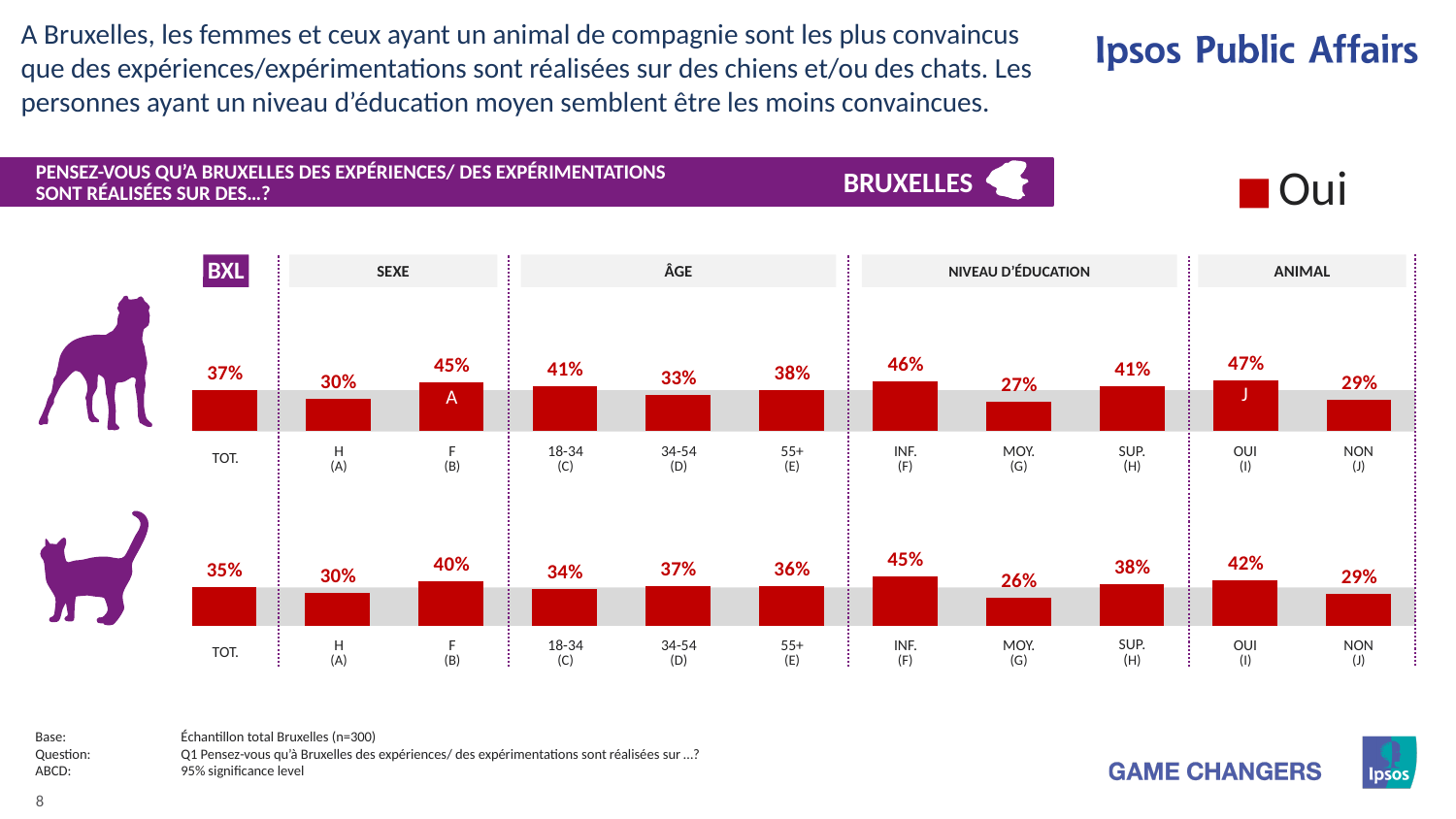
How many categories (bars) are shown in the bottom chart (cat row)? 11 In the bottom chart (cat row), what is the value for 34-54 (D) under ÂGE? 37% In the bottom chart (cat row), what is the difference between the values for INF. (F) and SUP. (H)? 7% In the bottom chart (cat row), which category has the lowest value? MOY. (G) What type of chart is used on this slide? Bar chart In the top chart (dog row), what is the difference between the values for F (B) and H (A)? 15% In the top chart (dog row), which category has the highest value? OUI (I) In the top chart (dog row), what is the value for MOY. (G) under NIVEAU D'ÉDUCATION? 27% In the bottom chart (cat row), what is the value for F (B) under SEXE? 40% In the top chart (dog row), which is larger: the value for 18-34 (C) or the value for 55+ (E)? 18-34 (C) What is the single legend entry shown on the slide? Oui In the top chart (dog row), what is the value for TOT.? 37%